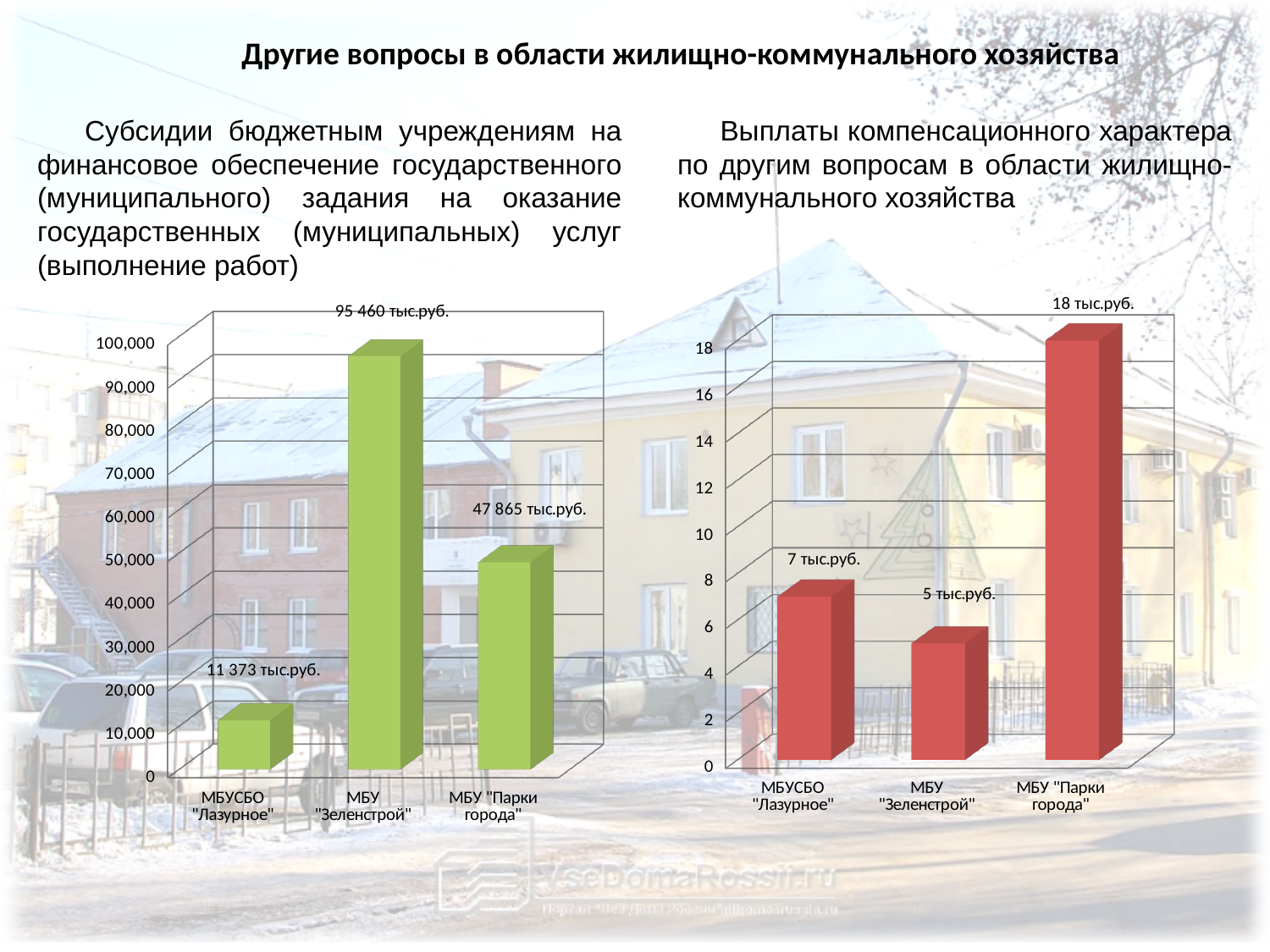
In the right chart, what is the value for МБУ "Парки города"? 18 тыс.руб. In the left chart, which category has the lowest value? МБУСБО "Лазурное" In the right chart, which category has the lowest value? МБУ "Зеленстрой" How many categories are shown in the left chart? 3 In the right chart, which is larger: the value for МБУСБО "Лазурное" or МБУ "Зеленстрой"? МБУСБО "Лазурное" What kind of chart is the right chart? Bar chart In the left chart, what is the value for МБУСБО "Лазурное"? 11 373 тыс.руб. In the left chart, what is the value for МБУ "Зеленстрой"? 95 460 тыс.руб. In the right chart, what is the value for МБУ "Зеленстрой"? 5 тыс.руб. In the right chart, what is the difference between the values for МБУ "Парки города" and МБУСБО "Лазурное"? 11 тыс.руб. In the left chart, which category has the highest value? МБУ "Зеленстрой" In the left chart, what is the difference between the values for МБУ "Зеленстрой" and МБУ "Парки города"? 47 595 тыс.руб.